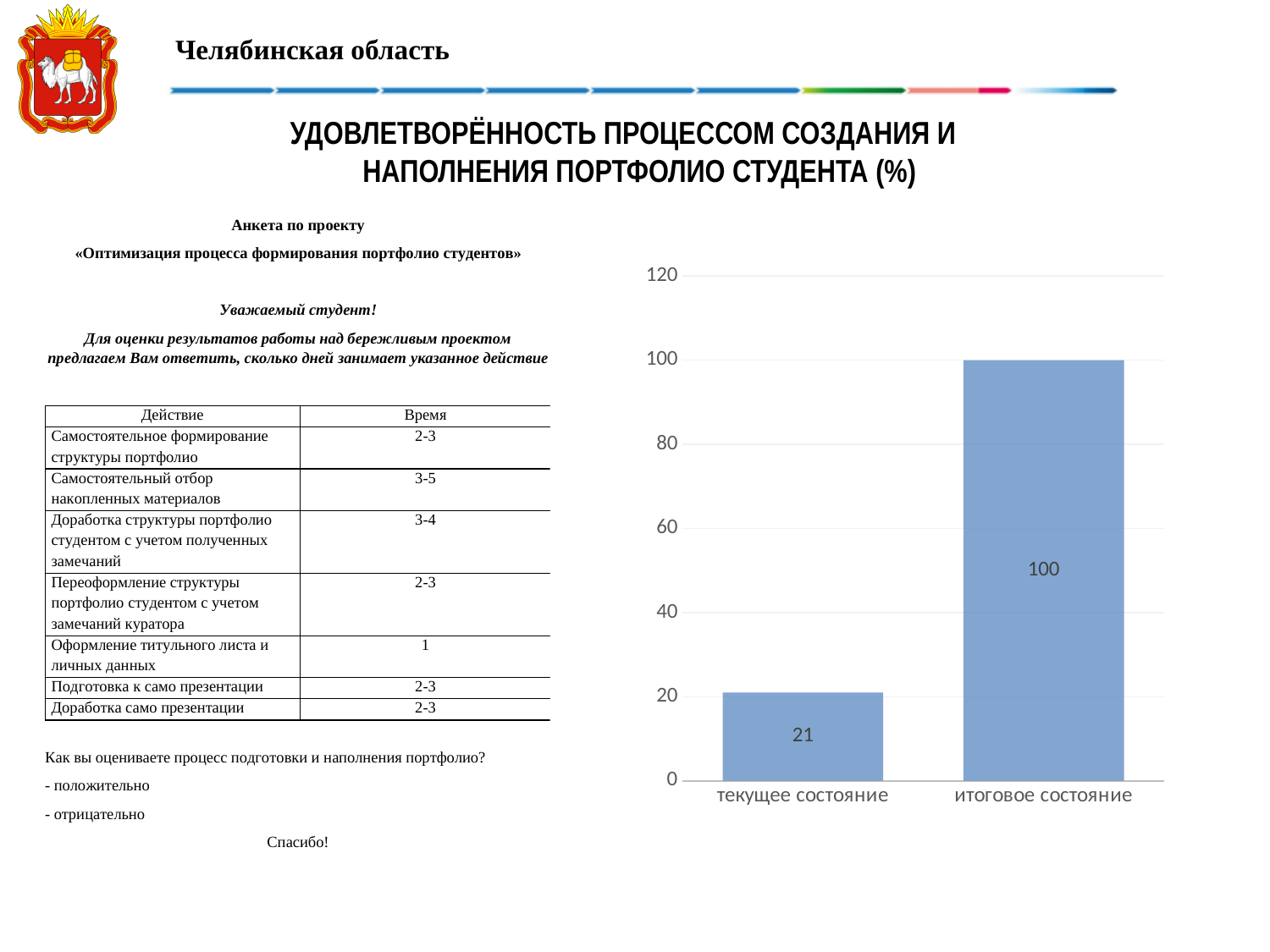
Is the value for "текущее состояние" greater or less than 40? less What is the value for "итоговое состояние"? 100 What is the difference between the values for "итоговое состояние" and "текущее состояние"? 79 What is the value for "текущее состояние"? 21 How many categories are shown on the chart? 2 Is the value for "итоговое состояние" greater or less than 80? greater Which category has the highest value? итоговое состояние Do the values rise or fall from "текущее состояние" to "итоговое состояние"? rise What is the highest tick value shown on the vertical axis of the chart? 120 Which is larger, the value for "текущее состояние" or for "итоговое состояние"? итоговое состояние Which category has the lowest value? текущее состояние What kind of chart is shown on the slide? bar chart